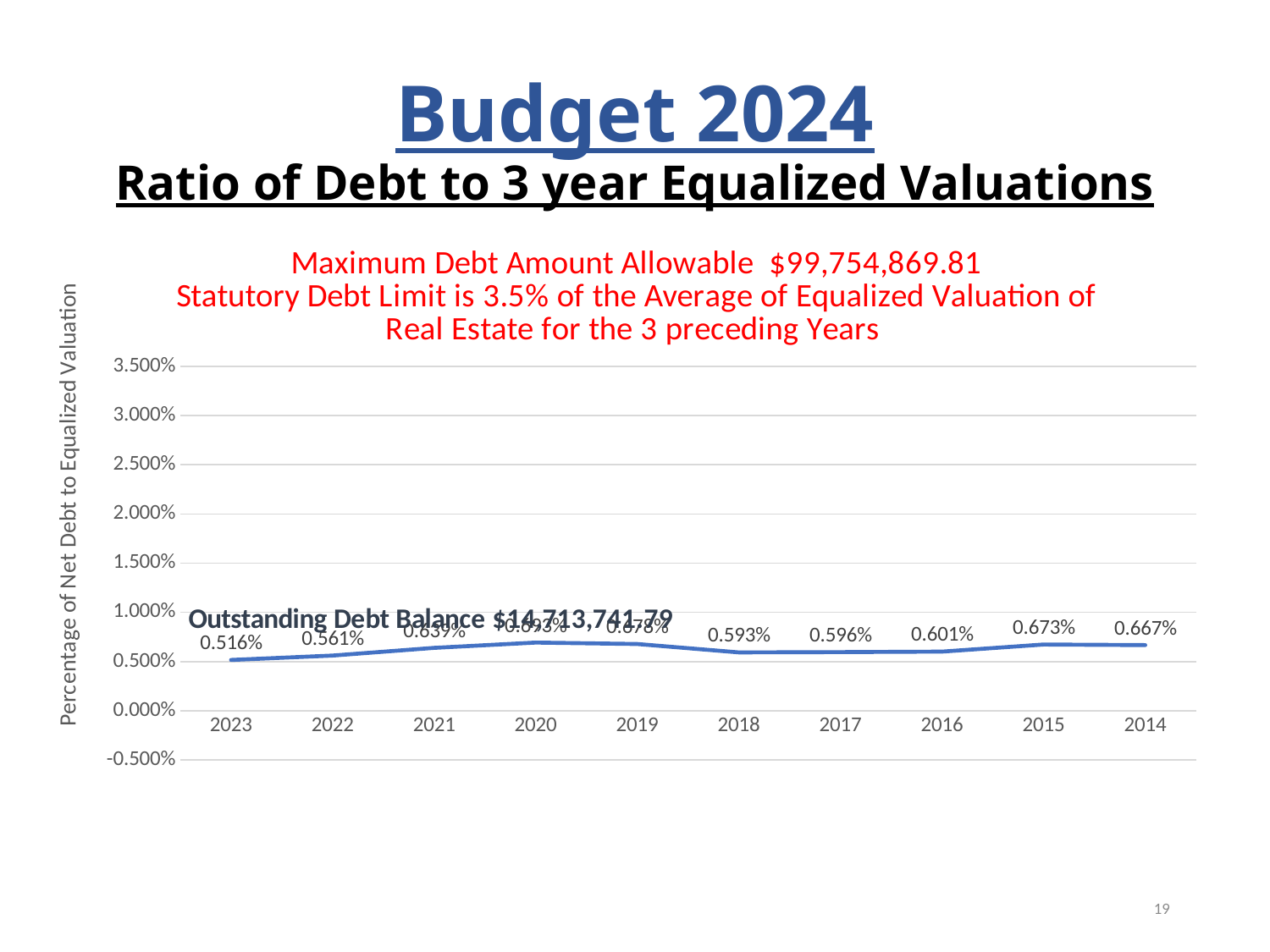
What kind of chart is this? line chart How many years are shown on the x axis? 10 What is the label on the vertical axis? Percentage of Net Debt to Equalized Valuation What is the value for 2023? 0.516% Which is larger, the value for 2015 or the value for 2014? 2015 What is the value for 2015? 0.673% Which is larger, the value for 2021 or the value for 2022? 2021 Which year has the lowest value? 2023 What is the difference between the values for 2022 and 2023? 0.045% What is the value for 2018? 0.593% What is the value for 2014? 0.667% Is the value for 2016 greater or less than 1.000%? less